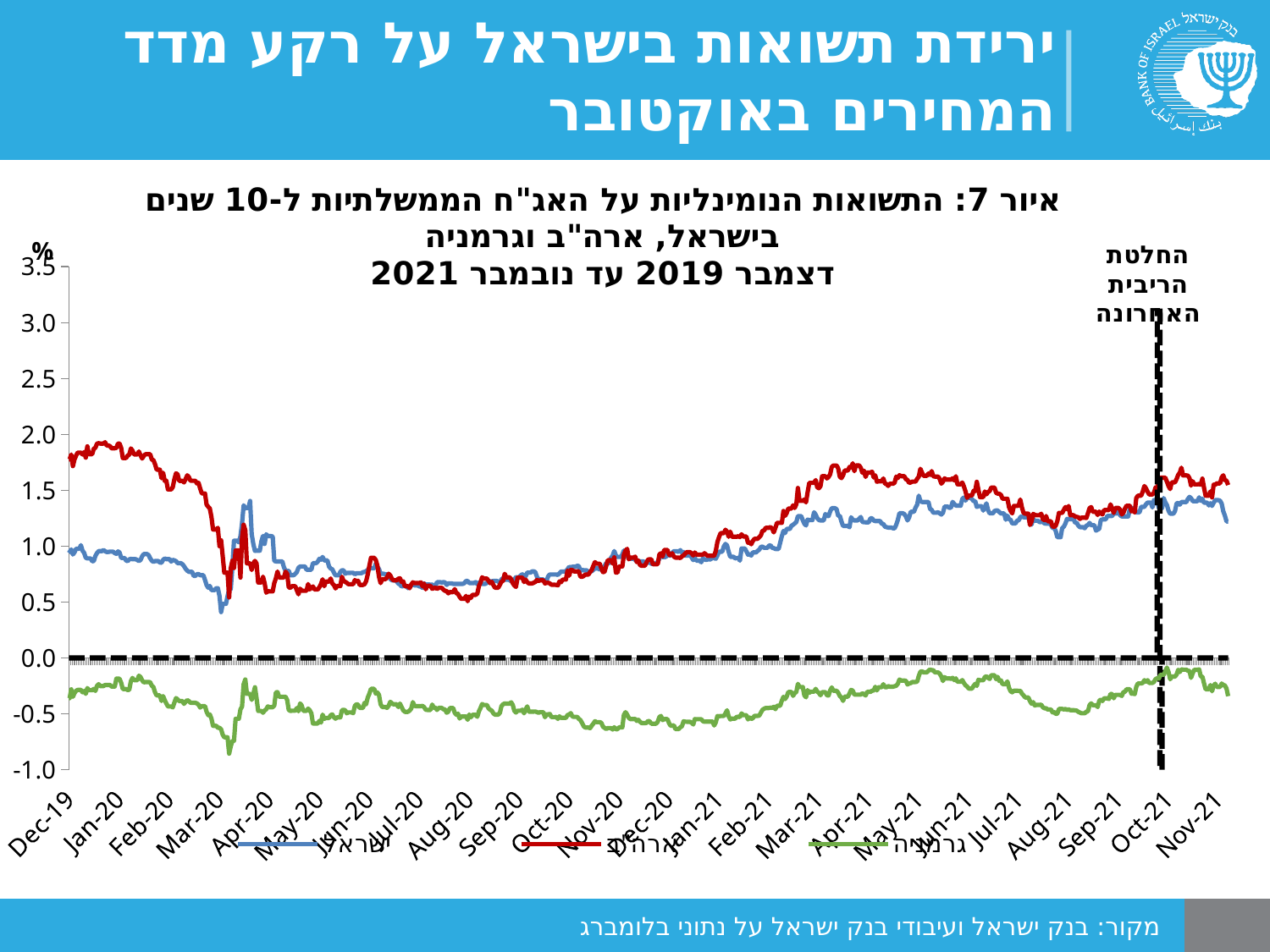
At Apr-20, which is larger: the blue (Israel) line or the red (US) line? the blue (Israel) line Is the value of the green (Germany) line at Dec-19 greater or less than 0.0? less How many month labels are shown along the x axis of the chart? 24 What is the highest tick value shown on the y axis of the chart? 3.5 Does the red (US) line rise or fall between Dec-19 and Mar-20? fall Is the lowest point of the green (Germany) line around Mar-20 greater or less than -0.5? less Which series has the highest value at Dec-19? US (ארה"ב, red line) How many series does the chart's legend list? 3 Does the red (US) line rise or fall between Aug-20 and Mar-21? rise Is the value of the red (US) line at Dec-19 greater or less than 1.5? greater Which series has the lowest values throughout the whole period shown? Germany (גרמניה, green line) What kind of chart is shown on the slide? line chart